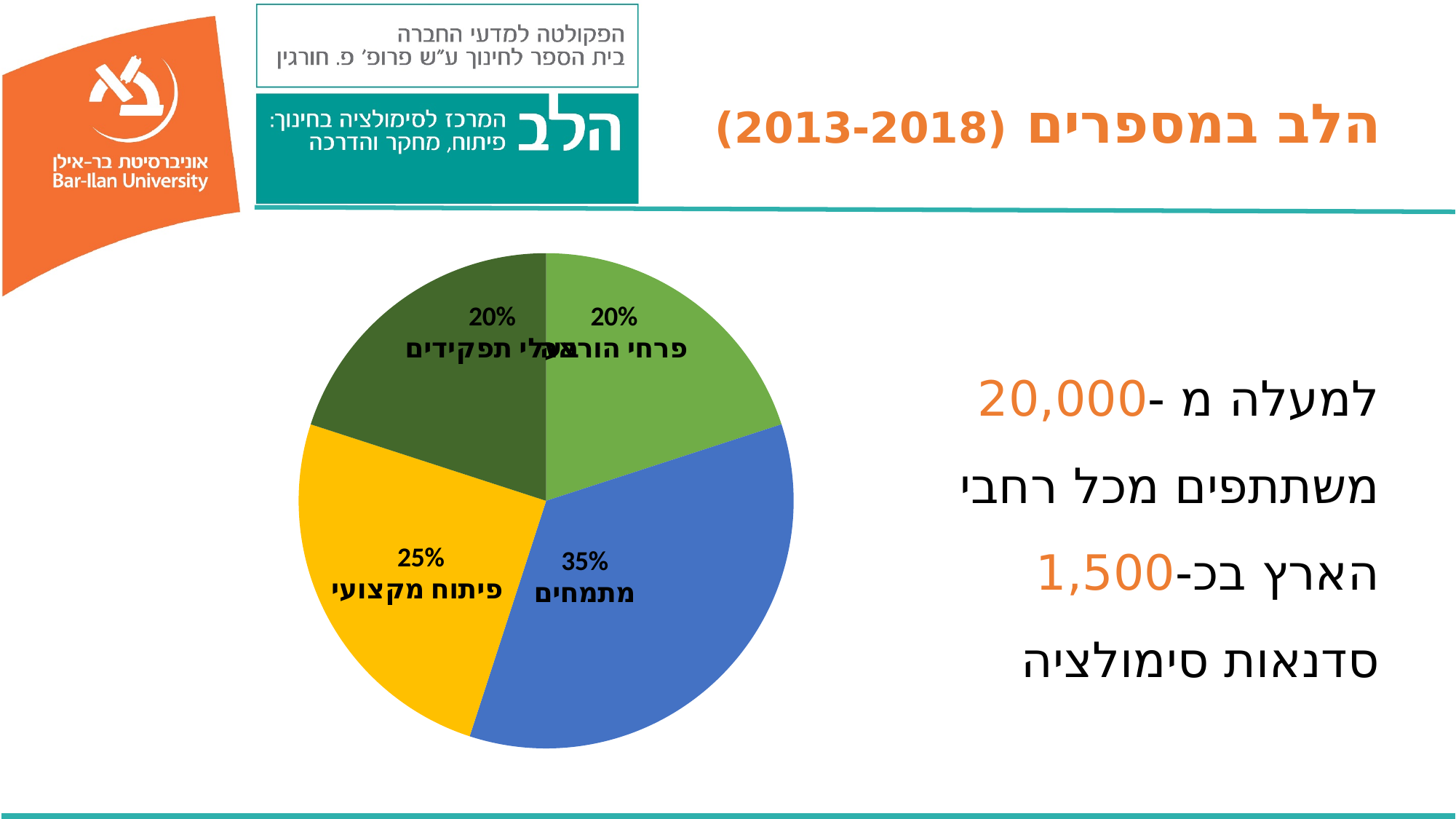
Which slice of the pie chart is the largest? מתמחים How many slices does the pie chart have? 4 Which two slices of the pie chart share the smallest percentage? פרחי הוראה and בעלי תפקידים What is the title of the slide containing the pie chart? הלב במספרים (2013-2018) Which slice is larger, מתמחים or פיתוח מקצועי? מתמחים What share of the pie chart is labelled מתמחים? 35% What share of the pie chart is labelled פיתוח מקצועי? 25% What is the difference in percentage points between the מתמחים slice and the פיתוח מקצועי slice? 10% What share of the pie chart is labelled פרחי הוראה? 20% What colour is the מתמחים slice of the pie chart? Blue What share of the pie chart is labelled בעלי תפקידים? 20% What kind of chart is shown on the slide? Pie chart